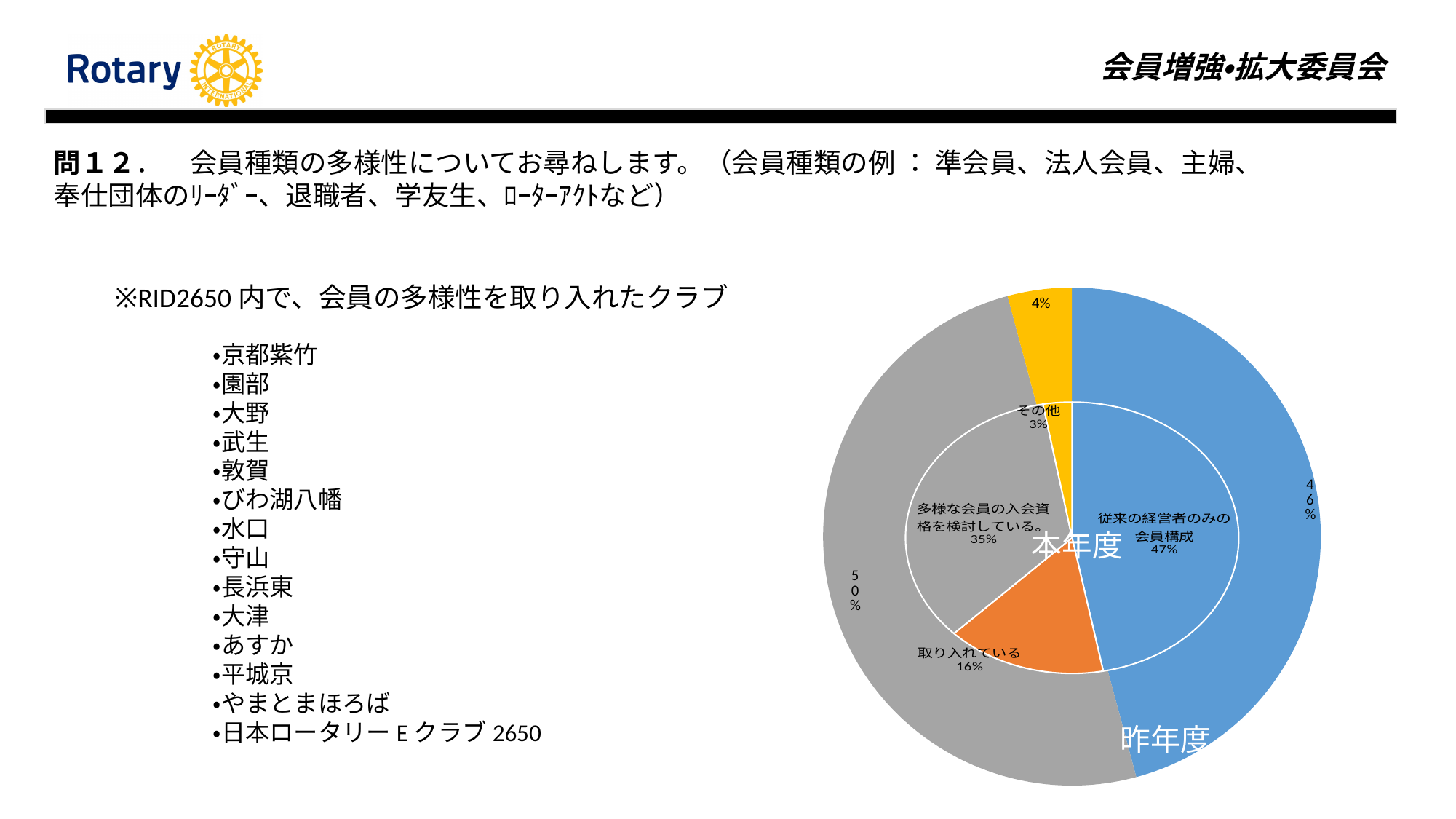
How many categories are labelled in the inner pie (本年度)? 4 In the inner pie (本年度), what percentage is shown for その他? 3% In the inner pie (本年度), what percentage is shown for 取り入れている? 16% In the inner pie (本年度), how many percentage points larger is 従来の経営者のみの会員構成 than 多様な会員の入会資格を検討している。? 12 In the outer ring (昨年度), what percentage is shown on the yellow slice? 4% In the outer ring (昨年度), what is the largest percentage shown? 50% Which category has the largest share in the inner pie (本年度)? 従来の経営者のみの会員構成 In the inner pie (本年度), what percentage is shown for 多様な会員の入会資格を検討している。? 35% What kind of chart is shown on the slide? pie chart In the inner pie (本年度), which is larger: 取り入れている or 多様な会員の入会資格を検討している。? 多様な会員の入会資格を検討している。 Which category has the smallest share in the inner pie (本年度)? その他 In the inner pie (本年度), what percentage is shown for 従来の経営者のみの会員構成? 47%